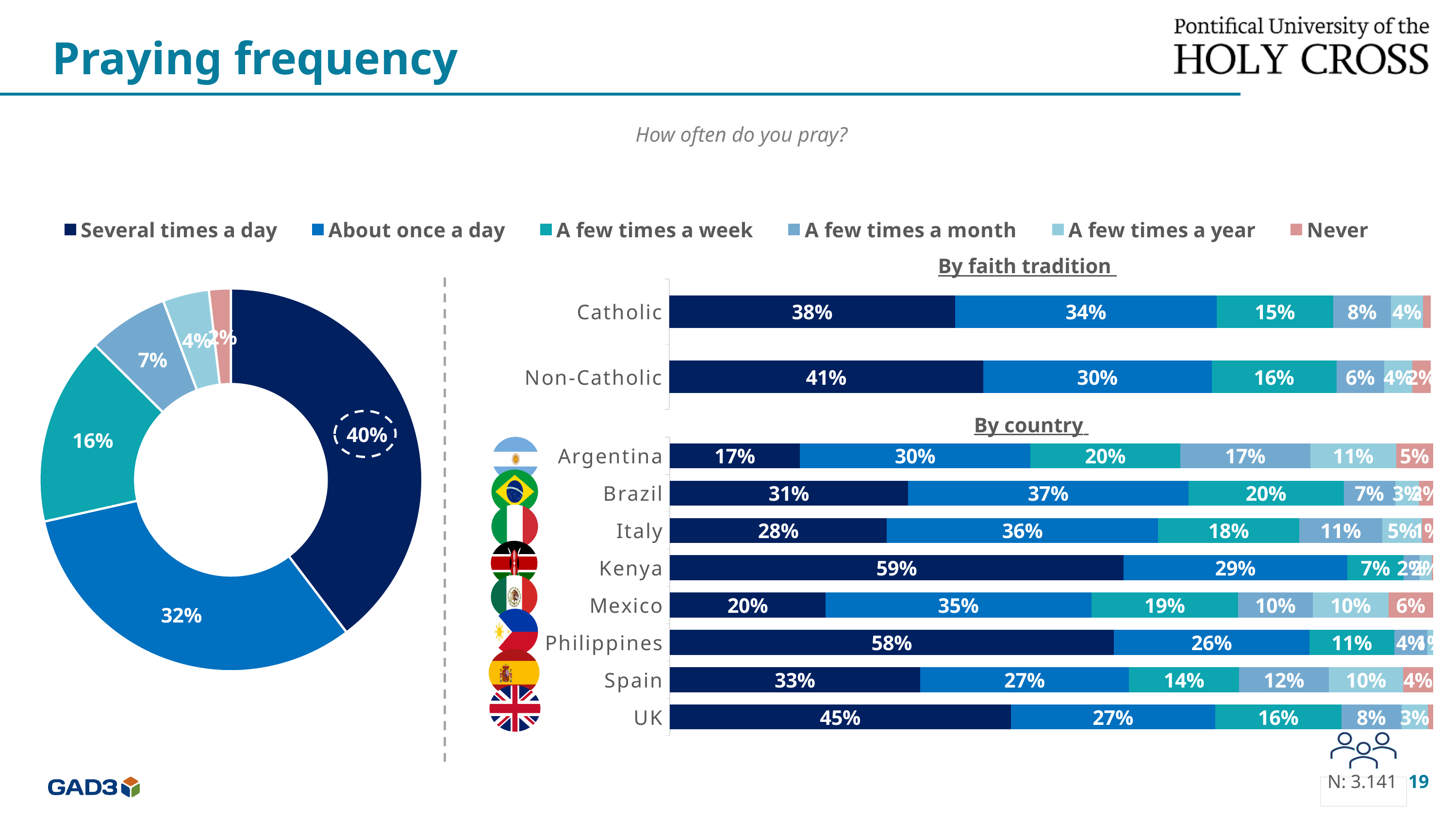
What kind of chart is shown on the left side of the slide? Pie (donut) chart In the 'By country' chart, what percentage of respondents in Argentina pray a few times a month? 17% How many countries are shown in the 'By country' chart? 8 In the donut chart on the left, what percentage of respondents pray several times a day? 40% In the 'By country' chart, what percentage of respondents in Kenya pray several times a day? 59% How many praying-frequency categories does the legend list? 6 In the donut chart on the left, which praying frequency has the largest share? Several times a day In the 'By faith tradition' chart, how many percentage points higher is the 'Several times a day' share for Non-Catholics than for Catholics? 3 percentage points In the 'By country' chart, which has the larger 'About once a day' share, Brazil or Italy? Brazil In the 'By faith tradition' chart, what percentage of Catholics pray about once a day? 34% In the 'By country' chart, which country has the highest share of respondents who pray several times a day? Kenya In the 'By country' chart, what percentage of respondents in Mexico never pray? 6%